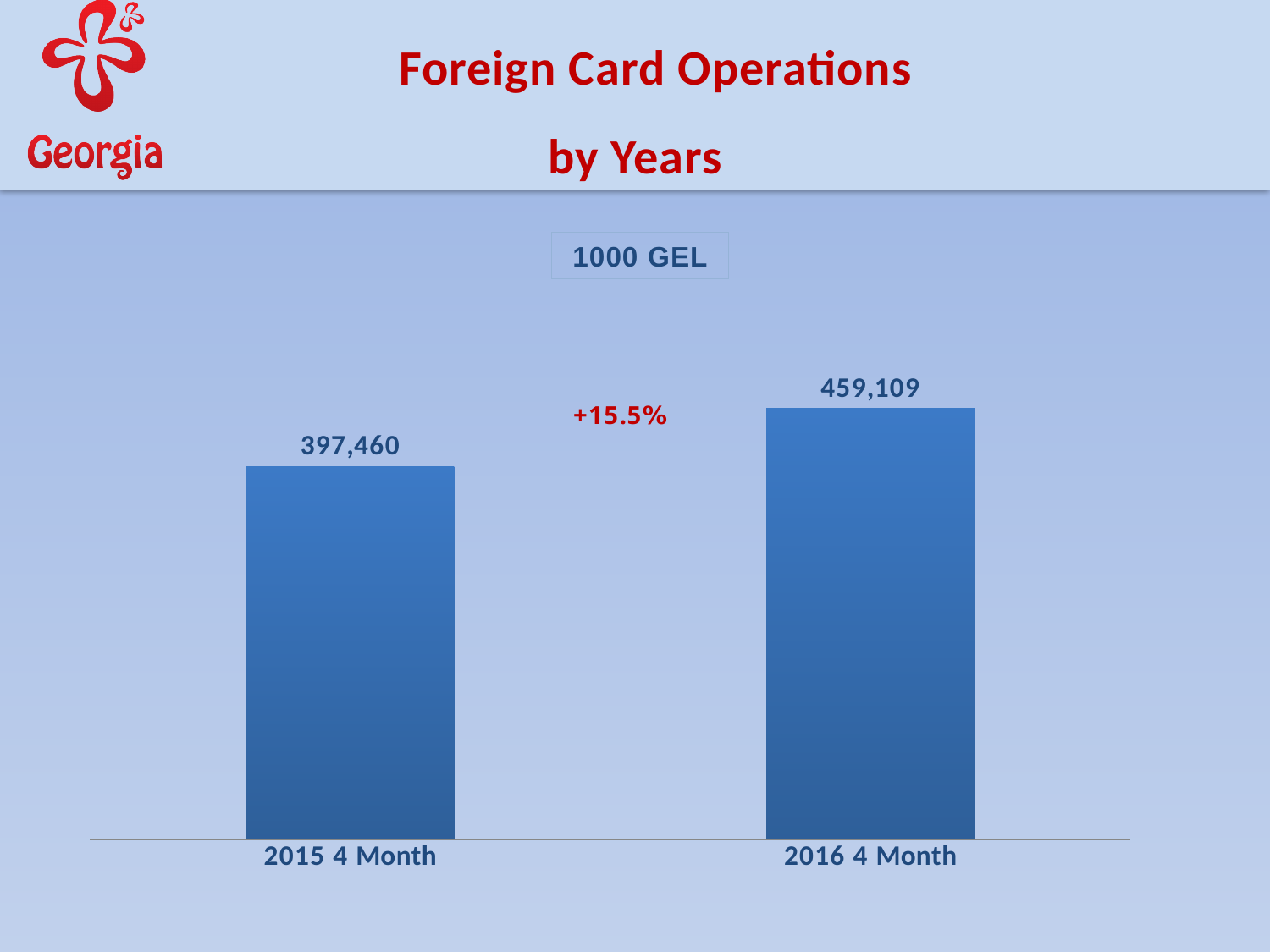
What unit label is shown above the chart? 1000 GEL Which is larger, the value for 2015 4 Month or 2016 4 Month? 2016 4 Month What is the value for 2015 4 Month? 397,460 What kind of chart is shown on the slide? bar chart How many bars are shown in the chart? 2 What percentage change is printed between the two bars? +15.5% What is the difference between the values for 2016 4 Month and 2015 4 Month? 61,649 What is the value for 2016 4 Month? 459,109 Which category has the lowest value? 2015 4 Month Which category has the highest value? 2016 4 Month Do the values rise or fall from 2015 4 Month to 2016 4 Month? rise